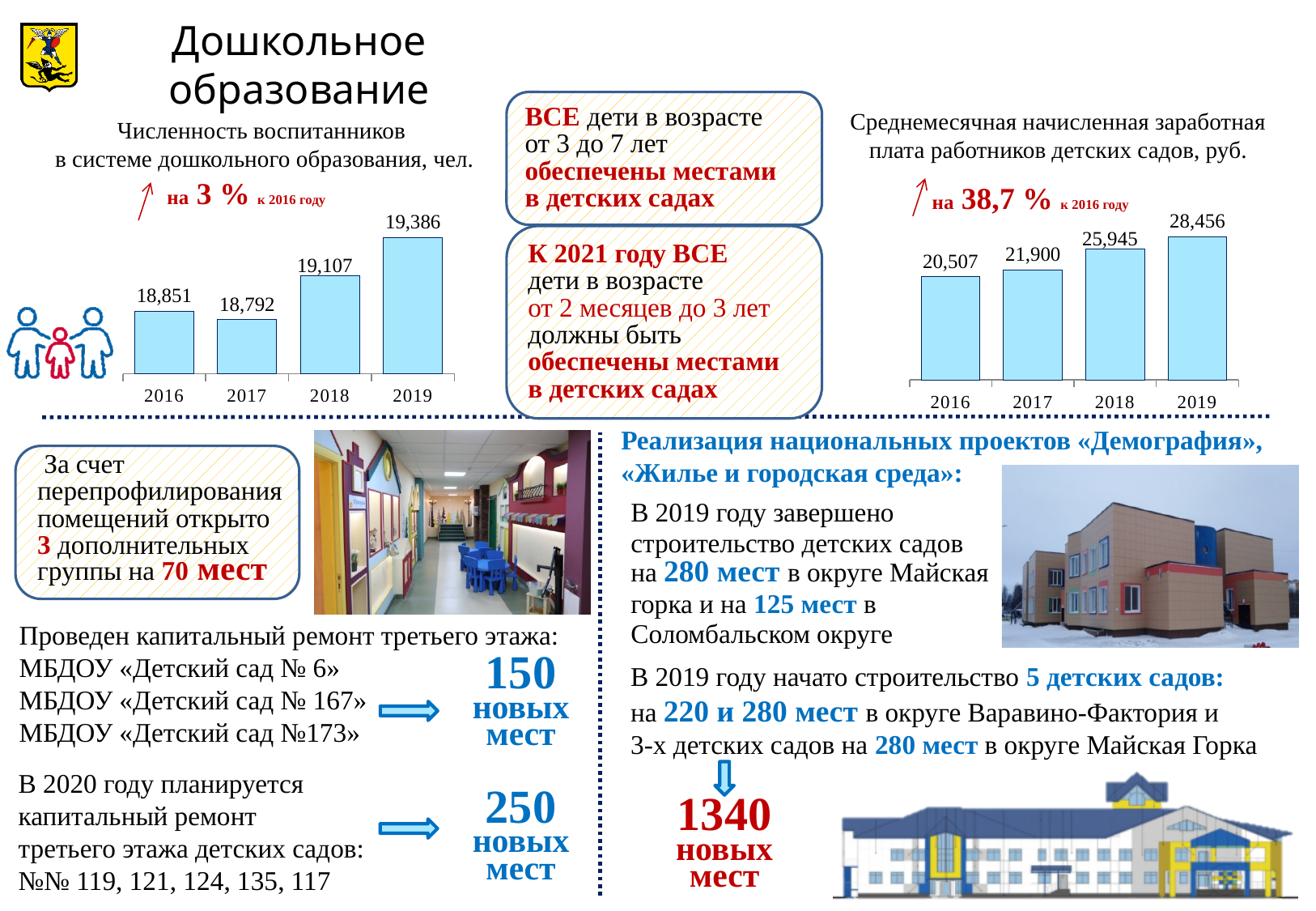
On the chart 'Среднемесячная начисленная заработная плата работников детских садов, руб.', what is the value for 2018? 25,945 On the chart 'Среднемесячная начисленная заработная плата работников детских садов, руб.', which year has the highest value? 2019 On the chart 'Численность воспитанников в системе дошкольного образования, чел.', which year has the lowest value? 2017 On the chart 'Численность воспитанников в системе дошкольного образования, чел.', how many years are shown? 4 What type of chart is 'Численность воспитанников в системе дошкольного образования, чел.'? bar chart On the chart 'Численность воспитанников в системе дошкольного образования, чел.', what is the difference between the 2019 and 2016 values? 535 On the chart 'Численность воспитанников в системе дошкольного образования, чел.', which is larger, the value for 2016 or the value for 2018? 2018 On the chart 'Среднемесячная начисленная заработная плата работников детских садов, руб.', do the values rise or fall from 2016 to 2019? rise On the chart 'Среднемесячная начисленная заработная плата работников детских садов, руб.', what is the value for 2016? 20,507 On the chart 'Численность воспитанников в системе дошкольного образования, чел.', what is the value for 2019? 19,386 On the chart 'Среднемесячная начисленная заработная плата работников детских садов, руб.', what is the difference between the 2019 and 2018 values? 2,511 On the chart 'Численность воспитанников в системе дошкольного образования, чел.', what is the value for 2017? 18,792